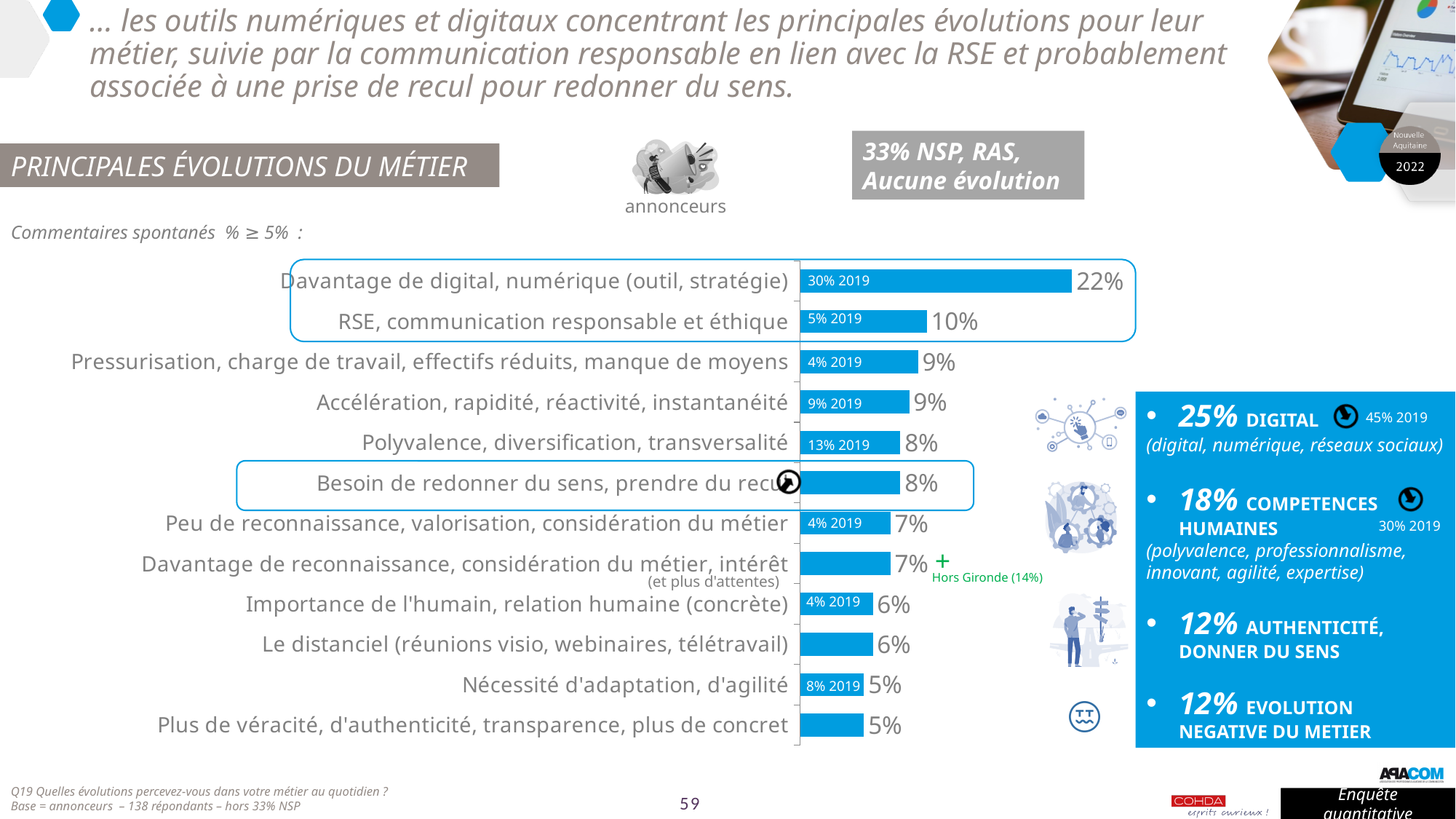
What is the difference between the values for "Pressurisation, charge de travail, effectifs réduits, manque de moyens" and "Plus de véracité, d'authenticité, transparence, plus de concret"? 4% What kind of chart is shown on the slide? bar chart How many categories are plotted in the bar chart? 12 Which is larger: the value for "Polyvalence, diversification, transversalité" or the value for "Importance de l'humain, relation humaine (concrète)"? Polyvalence, diversification, transversalité Which category has the highest value in the chart? Davantage de digital, numérique (outil, stratégie) Do the bar values rise or fall going from the top category to the bottom category? fall What 2019 value is shown inside the bar for "Davantage de digital, numérique (outil, stratégie)"? 30% What is the value for "Davantage de digital, numérique (outil, stratégie)"? 22% What is the value for "Nécessité d'adaptation, d'agilité"? 5% What is the value for "RSE, communication responsable et éthique"? 10% What is the difference between the values for "Davantage de digital, numérique (outil, stratégie)" and "RSE, communication responsable et éthique"? 12% What is the value for "Le distanciel (réunions visio, webinaires, télétravail)"? 6%